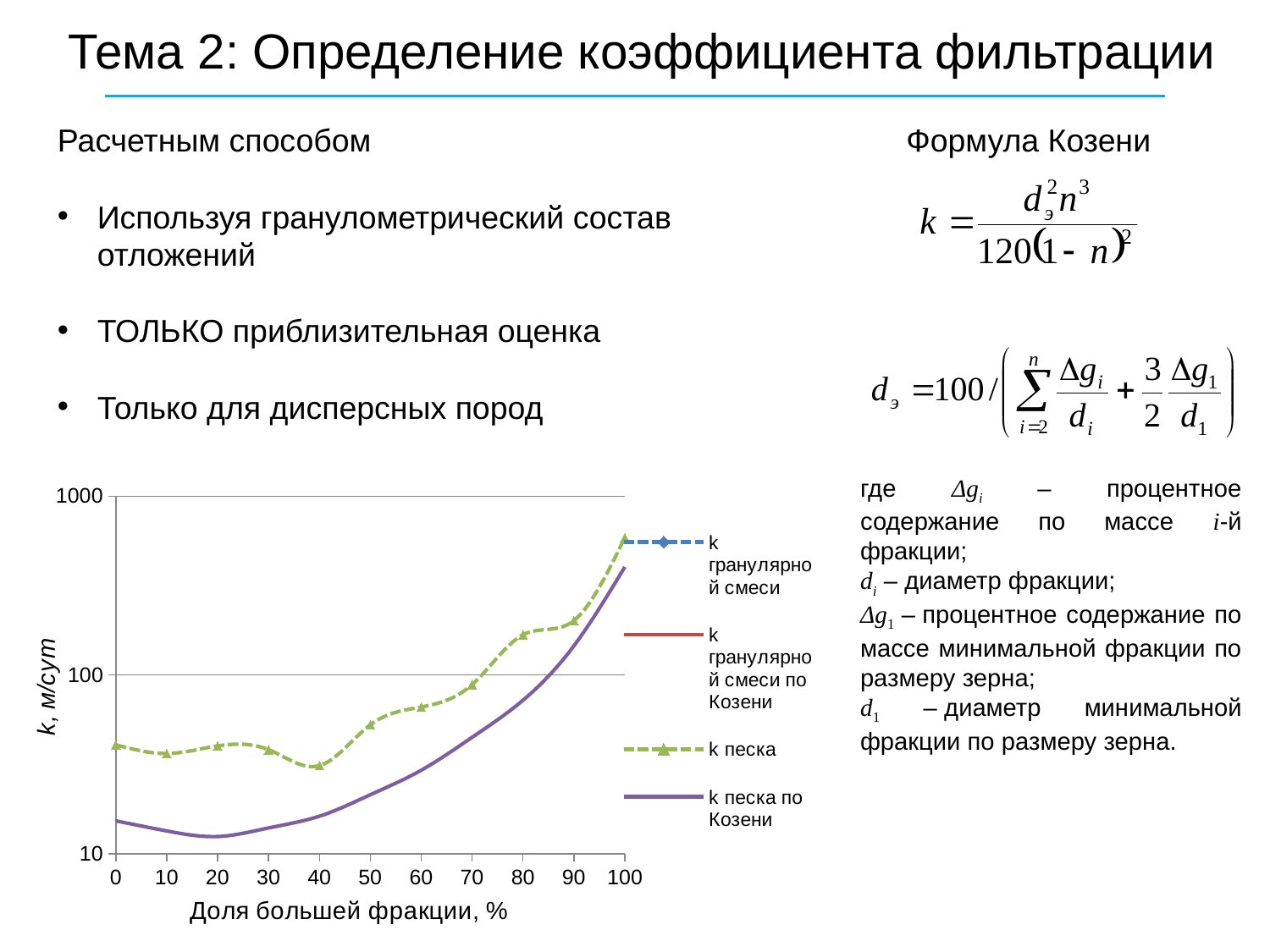
Is the value of the 'k песка по Козени' series at 0% greater or less than 100? less What kind of chart is shown on the slide? line chart Is the value of the 'k песка' series at 100% greater or less than 100? greater At 50% share of the larger fraction, which series has the larger value: 'k песка' or 'k песка по Козени'? k песка At which x-axis value does the 'k песка по Козени' series reach its lowest point? 20 Is the value of the 'k песка' series at 0% greater or less than 100? less At which x-axis value does the 'k песка' series reach its highest point? 100 Does the 'k песка' series rise or fall between 40% and 100% on the x axis? rise How many series does the chart legend list? 4 What is the title of the y axis of the chart? k, м/сут What is the title of the x axis of the chart? Доля большей фракции, %